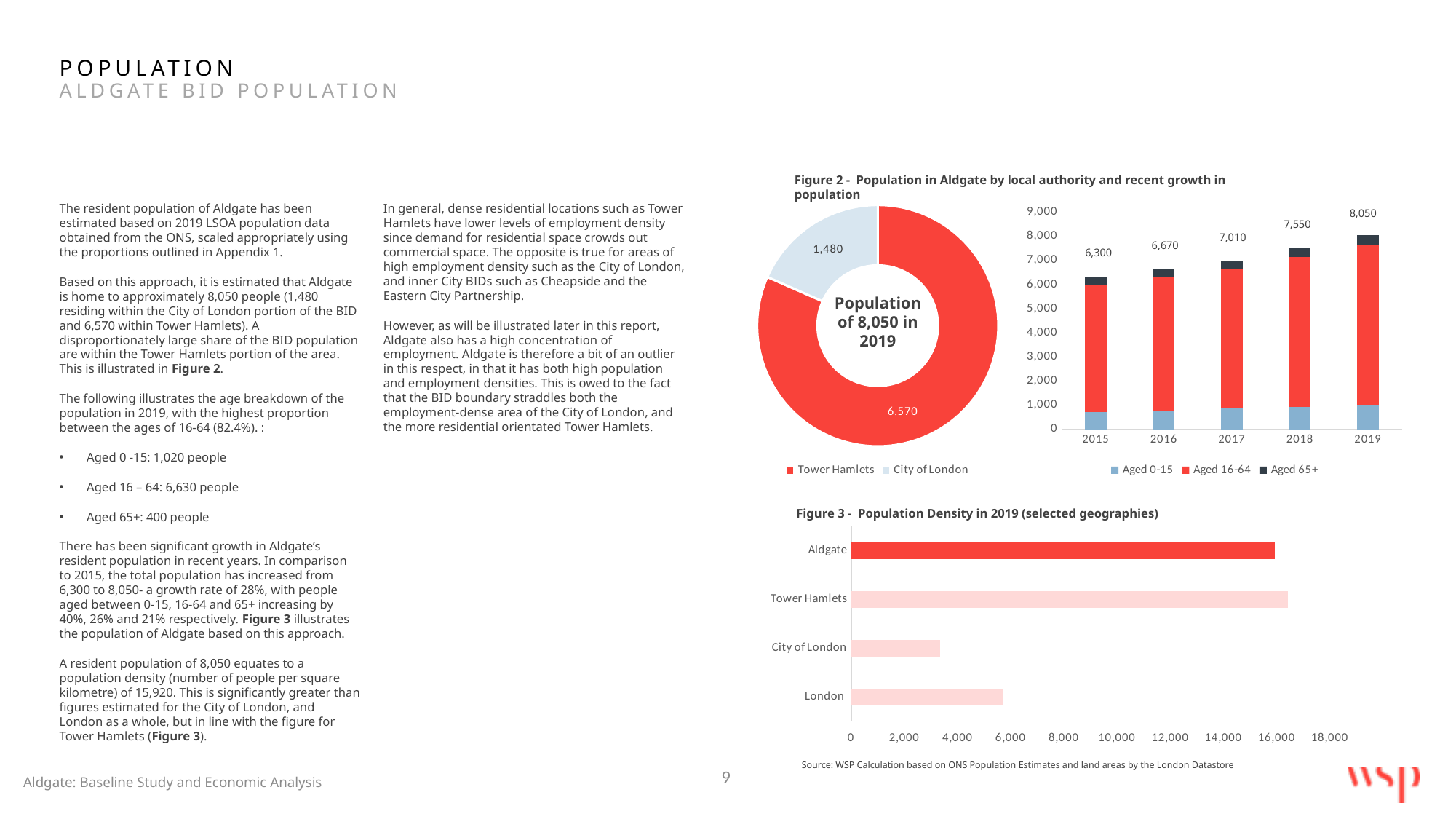
In Figure 3, which geography has the lowest population density? City of London In the stacked bar chart of Figure 2, how many series does the legend list? 3 In the stacked bar chart of Figure 2, does the total population rise or fall from 2015 to 2019? rise In the stacked bar chart of Figure 2, what is the total population shown for 2017? 7,010 In the donut chart of Figure 2, what total population is stated in the centre of the chart? Population of 8,050 in 2019 What kind of chart is Figure 3? bar chart In the donut chart of Figure 2, what is the population value shown for City of London? 1,480 In the donut chart of Figure 2, what is the population value shown for Tower Hamlets? 6,570 In the stacked bar chart of Figure 2, which year has the lowest total population? 2015 In the donut chart of Figure 2, which local authority has the larger share of Aldgate's population? Tower Hamlets In Figure 3, is the value for Aldgate greater or less than 14,000? greater In the stacked bar chart of Figure 2, what is the difference between the total population in 2019 and in 2015? 1,750